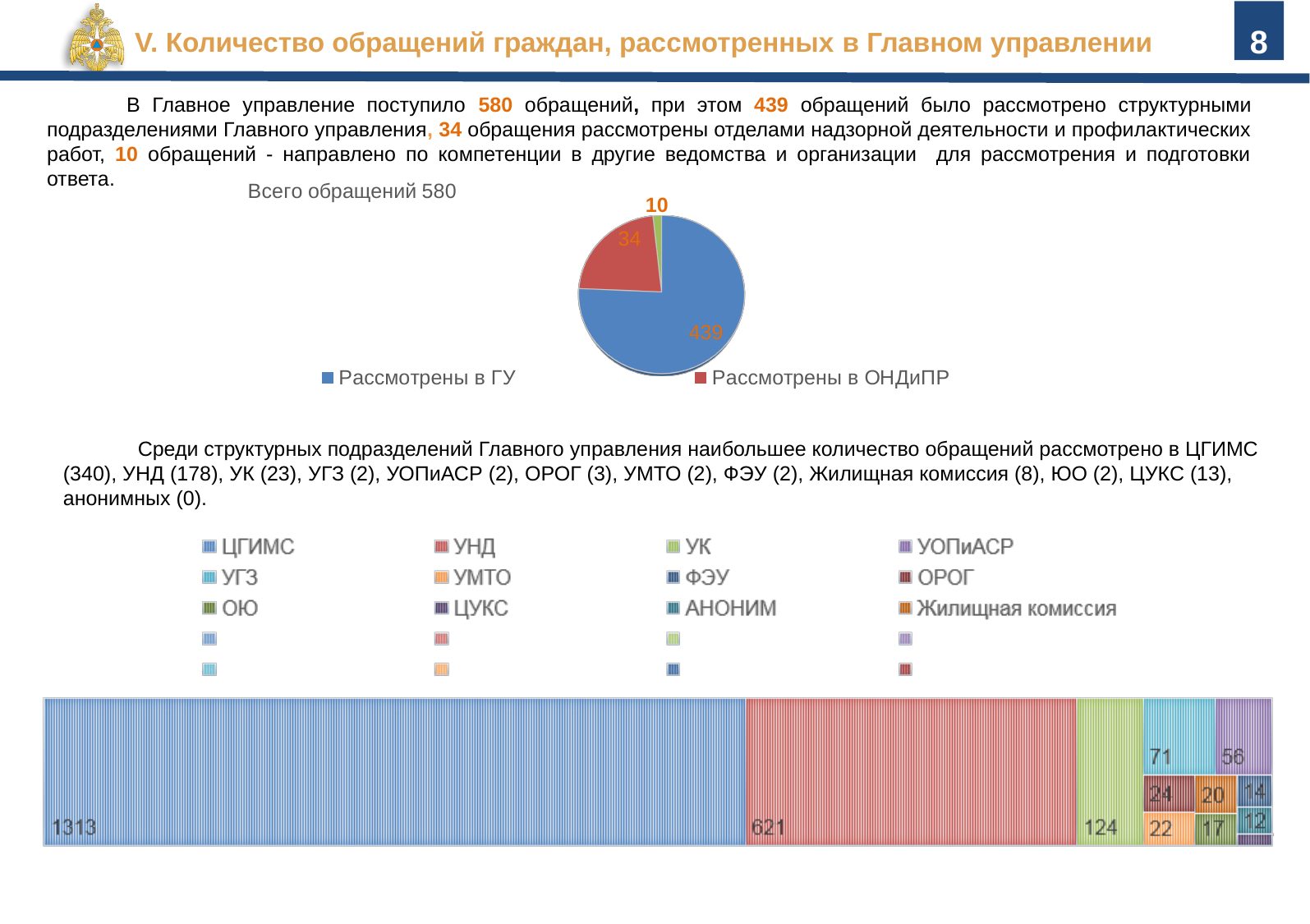
What total number of appeals is stated in the title of the pie chart? 580 In the pie chart titled 'Всего обращений 580', which legend category has the largest slice? Рассмотрены в ГУ In the chart at the bottom of the slide, what is the smallest value printed? 12 In the chart at the bottom of the slide, what is the difference between the two largest printed values, 1313 and 621? 692 How many named categories does the legend of the chart at the bottom of the slide list? 12 In the pie chart titled 'Всего обращений 580', what is the value for 'Рассмотрены в ГУ'? 439 In the pie chart titled 'Всего обращений 580', what is the difference between the values for 'Рассмотрены в ГУ' and 'Рассмотрены в ОНДиПР'? 405 In the pie chart titled 'Всего обращений 580', what is the value of the smallest slice? 10 In the pie chart titled 'Всего обращений 580', what is the value for 'Рассмотрены в ОНДиПР'? 34 What kind of chart is the chart titled 'Всего обращений 580'? pie chart In the chart at the bottom of the slide, what is the largest value printed? 1313 In the pie chart titled 'Всего обращений 580', which is larger: 'Рассмотрены в ГУ' or 'Рассмотрены в ОНДиПР'? Рассмотрены в ГУ